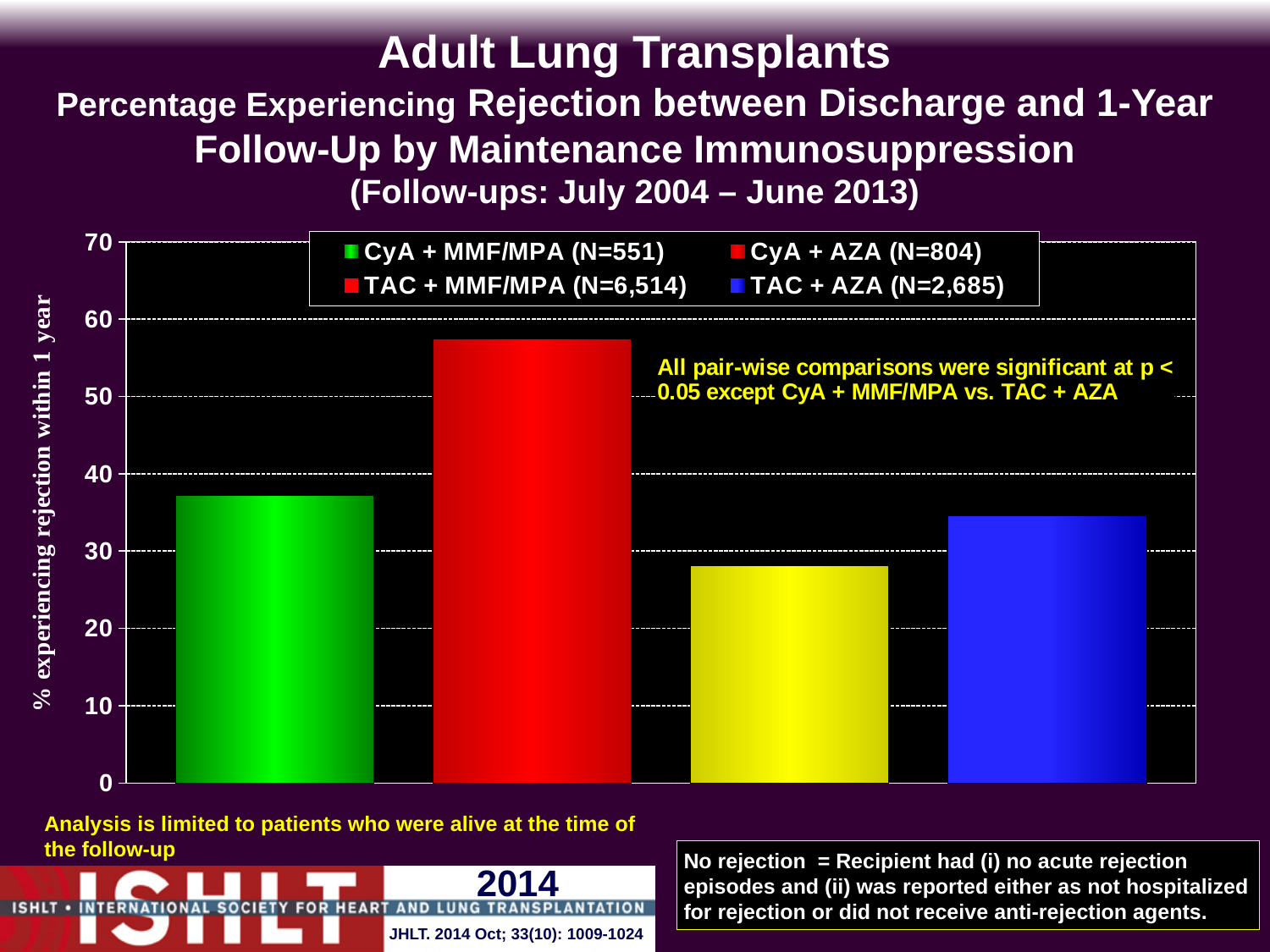
What is the sample size (N) shown in the legend for TAC + MMF/MPA? 6,514 What is the label on the y axis of the chart? % experiencing rejection within 1 year Is the value for CyA + AZA greater or less than 50? greater How many bars are plotted in the chart? 4 What kind of chart is shown on the slide? bar chart Is the value for TAC + MMF/MPA greater or less than 30? less Which maintenance immunosuppression group has the highest percentage experiencing rejection within 1 year? CyA + AZA Which has a higher percentage experiencing rejection, CyA + AZA or TAC + AZA? CyA + AZA Is the value for CyA + MMF/MPA greater or less than 40? less Which maintenance immunosuppression group has the lowest percentage experiencing rejection within 1 year? TAC + MMF/MPA How many series does the legend list? 4